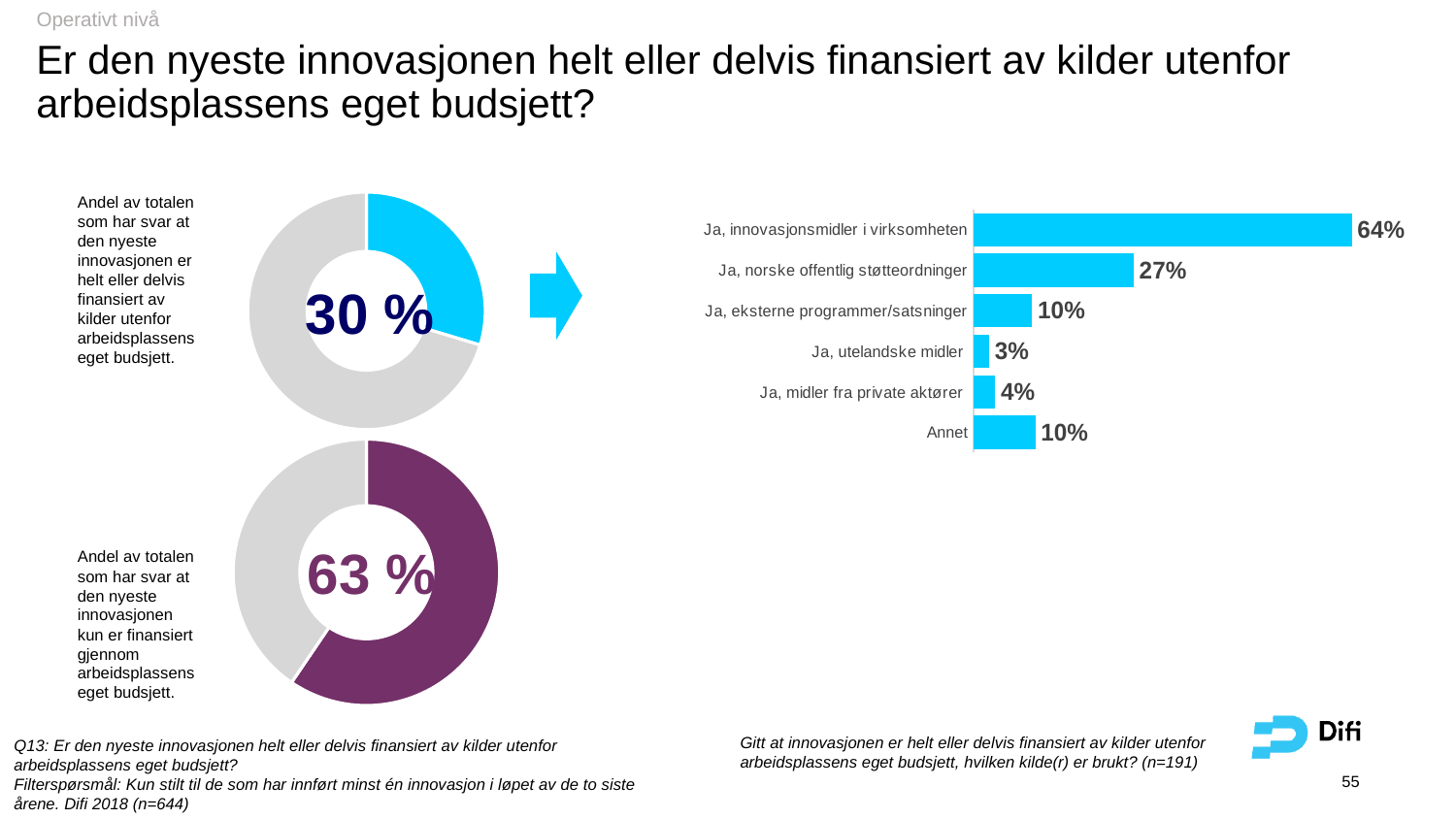
In the horizontal bar chart on the right, what is the value for "Ja, midler fra private aktører"? 4% In the horizontal bar chart on the right, what is the value for "Ja, innovasjonsmidler i virksomheten"? 64% In the horizontal bar chart on the right, which category has the lowest value? Ja, utelandske midler In the horizontal bar chart on the right, what is the value for "Ja, norske offentlig støtteordninger"? 27% In the horizontal bar chart on the right, what is the difference between "Ja, innovasjonsmidler i virksomheten" and "Ja, norske offentlig støtteordninger"? 37% In the horizontal bar chart on the right, which is larger: "Ja, eksterne programmer/satsninger" or "Ja, midler fra private aktører"? Ja, eksterne programmer/satsninger In the top donut chart on the left, what share of the total has the newest innovation fully or partly financed by sources outside the workplace's own budget? 30 % In the horizontal bar chart on the right, which category has the highest value? Ja, innovasjonsmidler i virksomheten What kind of chart is shown on the right side of the slide? Bar chart How many categories does the horizontal bar chart on the right show? 6 In the horizontal bar chart on the right, what is the value for "Ja, utelandske midler"? 3% In the bottom donut chart on the left, what share of the total has the newest innovation financed only through the workplace's own budget? 63 %